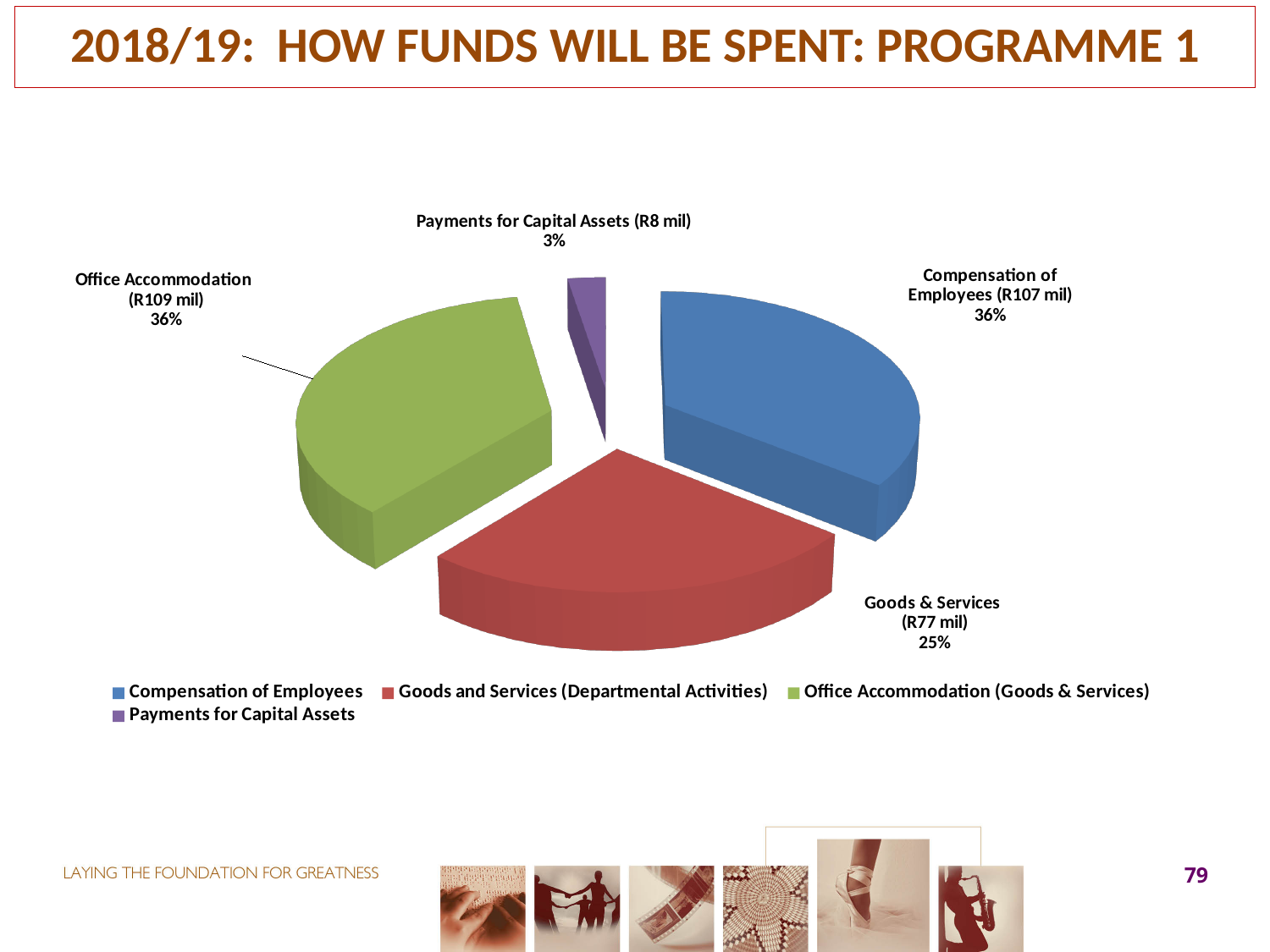
Which is larger, Compensation of Employees or Goods & Services? Compensation of Employees What amount is shown for Office Accommodation? R109 mil What type of chart is shown on the slide? pie chart What amount is shown for Goods & Services? R77 mil Which category has the smallest slice of the pie? Payments for Capital Assets What percentage share of the pie does Goods & Services represent? 25% What amount is shown for Payments for Capital Assets? R8 mil What is the difference between the amounts for Office Accommodation and Goods & Services? R32 mil What amount is shown for Compensation of Employees? R107 mil What is the title of the slide containing the chart? 2018/19: HOW FUNDS WILL BE SPENT: PROGRAMME 1 How many slices does the pie chart have? 4 What percentage share of the pie does Payments for Capital Assets represent? 3%